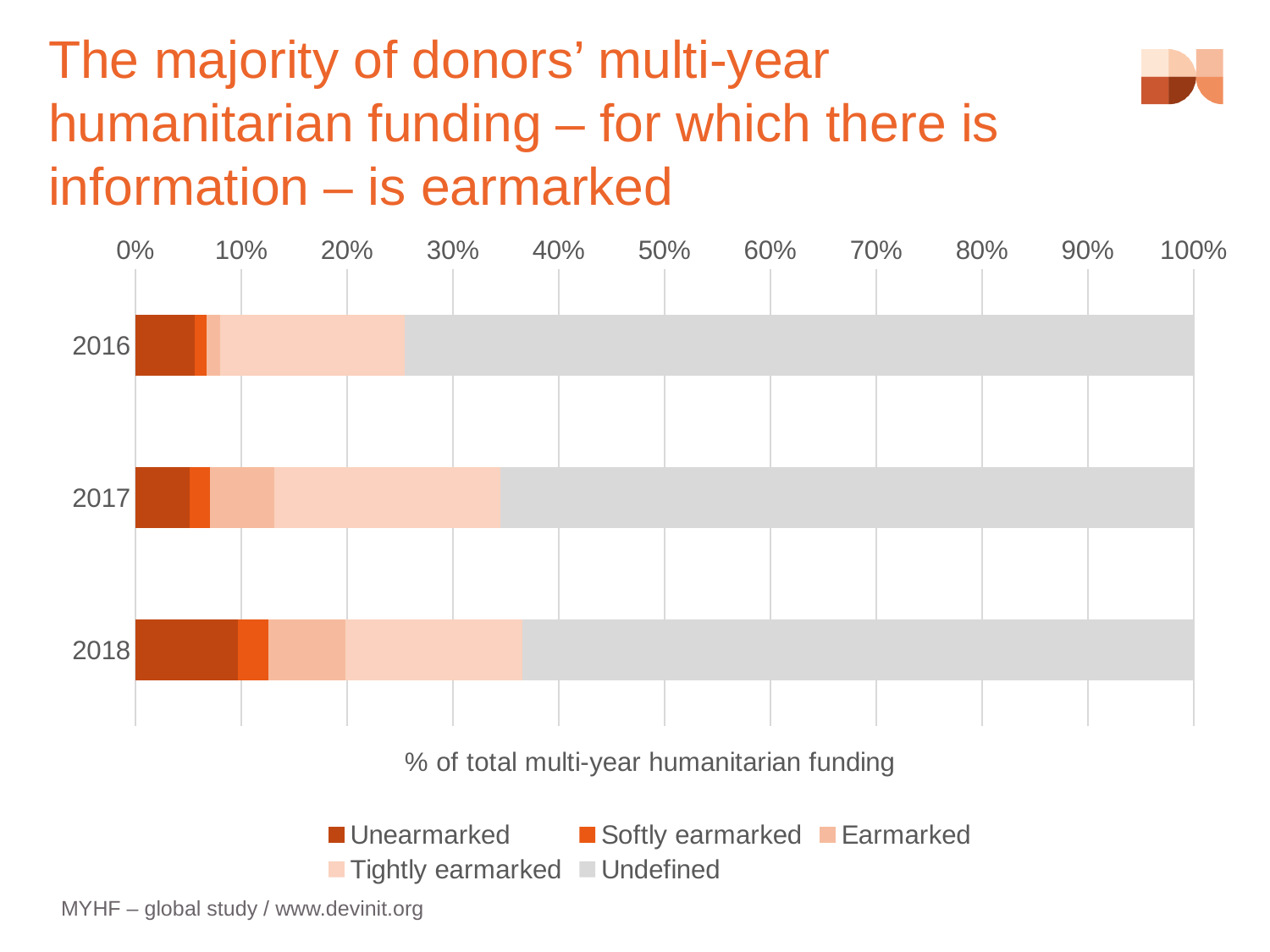
What is the label on the horizontal axis of the chart? % of total multi-year humanitarian funding Which year has the largest Unearmarked share? 2018 Is the Unearmarked share for 2016 greater or less than 10%? less Which legend entry is shown in grey? Undefined Is the Undefined share for 2018 greater or less than 60%? greater Is the Undefined share for 2016 greater or less than 70%? greater How many series does the legend list? 5 Which year has the largest Undefined share of multi-year humanitarian funding? 2016 What kind of chart is shown on the slide? Stacked bar chart How many years (categories) are plotted in the chart? 3 Does the Undefined share rise or fall from 2016 to 2018? Fall Which year has the larger Earmarked share, 2016 or 2018? 2018